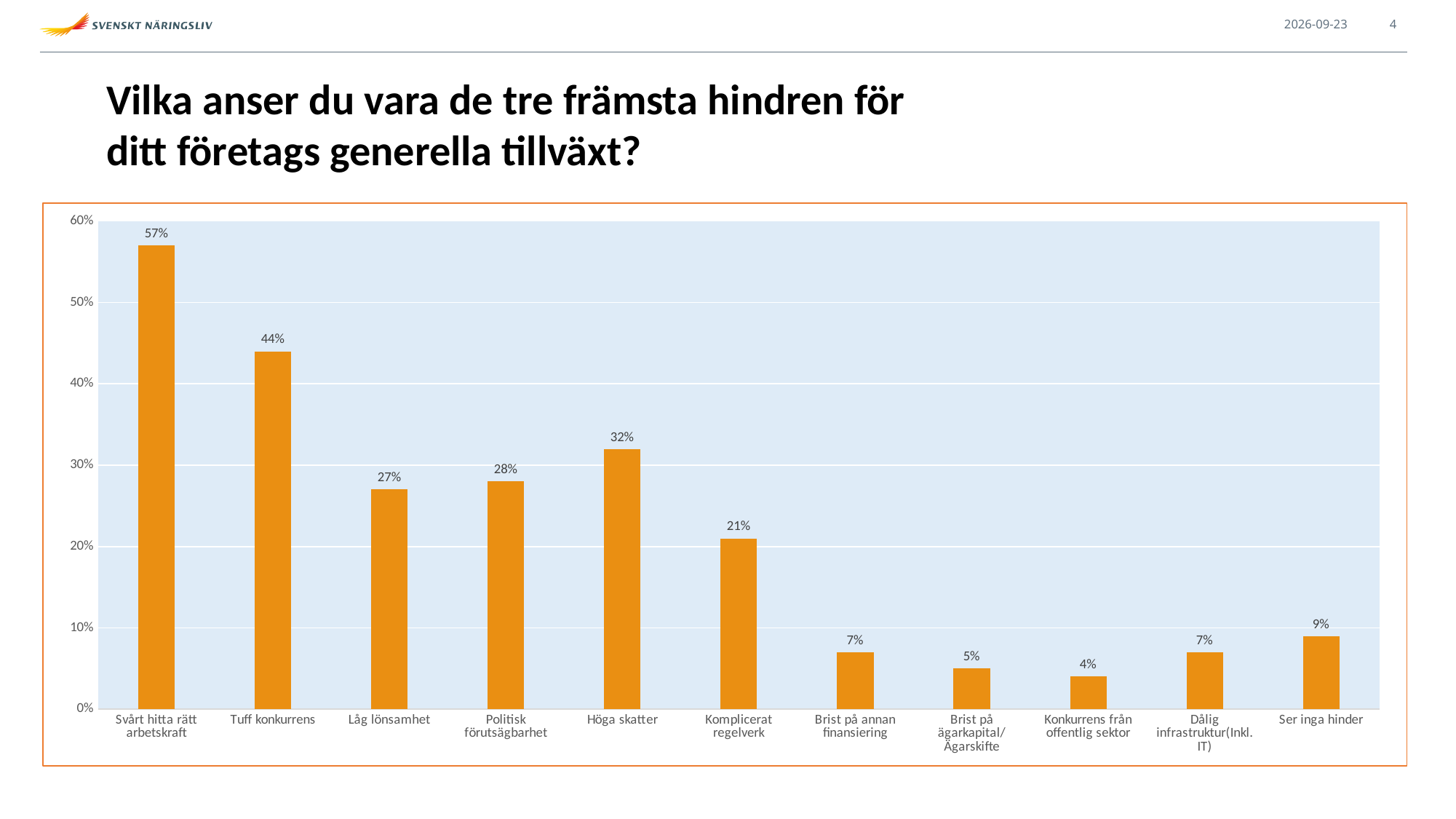
How many categories are shown on the x axis? 11 Which category has the lowest value? Konkurrens från offentlig sektor What is the value for "Svårt hitta rätt arbetskraft"? 57% What is the value for "Komplicerat regelverk"? 21% Is the value for "Tuff konkurrens" greater or less than 40%? greater What is the value for "Höga skatter"? 32% What is the value for "Ser inga hinder"? 9% Which category has the highest value? Svårt hitta rätt arbetskraft What is the difference between "Höga skatter" and "Komplicerat regelverk"? 11% What kind of chart is shown on the slide? Bar chart Which is larger, "Politisk förutsägbarhet" or "Låg lönsamhet"? Politisk förutsägbarhet What is the difference between "Svårt hitta rätt arbetskraft" and "Tuff konkurrens"? 13%